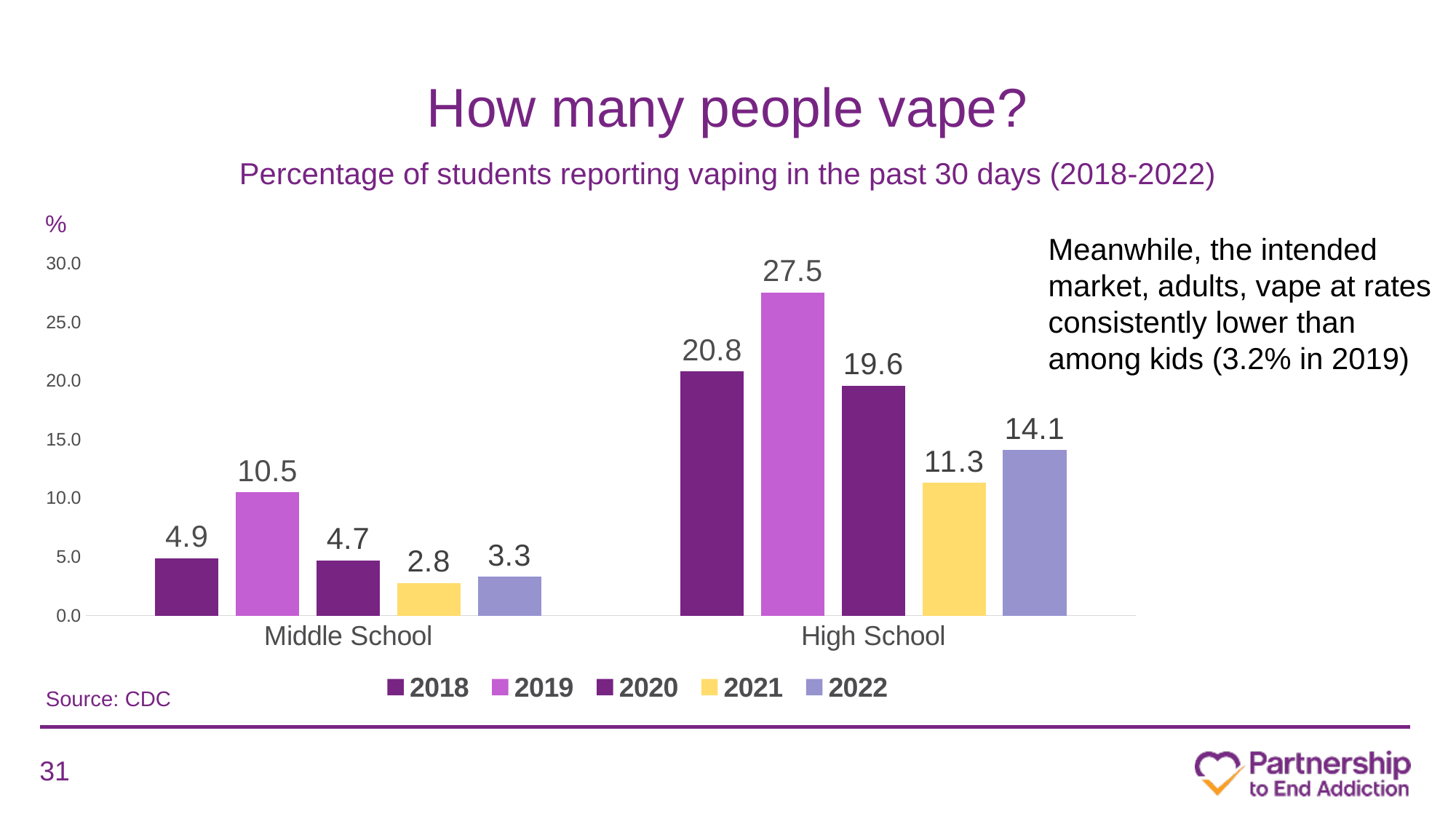
Which year has the lowest value for middle school students? 2021 How many series does the legend list? 5 What is the value for high school students in 2018? 20.8 What percentage of high school students reported vaping in 2022? 14.1 Which is larger, the middle school value for 2018 or for 2020? 2018 What kind of chart is shown on the slide? Bar chart Which year has the highest value for high school students? 2019 What is the source cited for the chart? CDC Is the value for high school students in 2020 greater or less than 15.0? greater What percentage of middle school students reported vaping in 2019? 10.5 What is the difference between the high school values for 2019 and 2020? 7.9 What is the difference between the high school and middle school values for 2021? 8.5